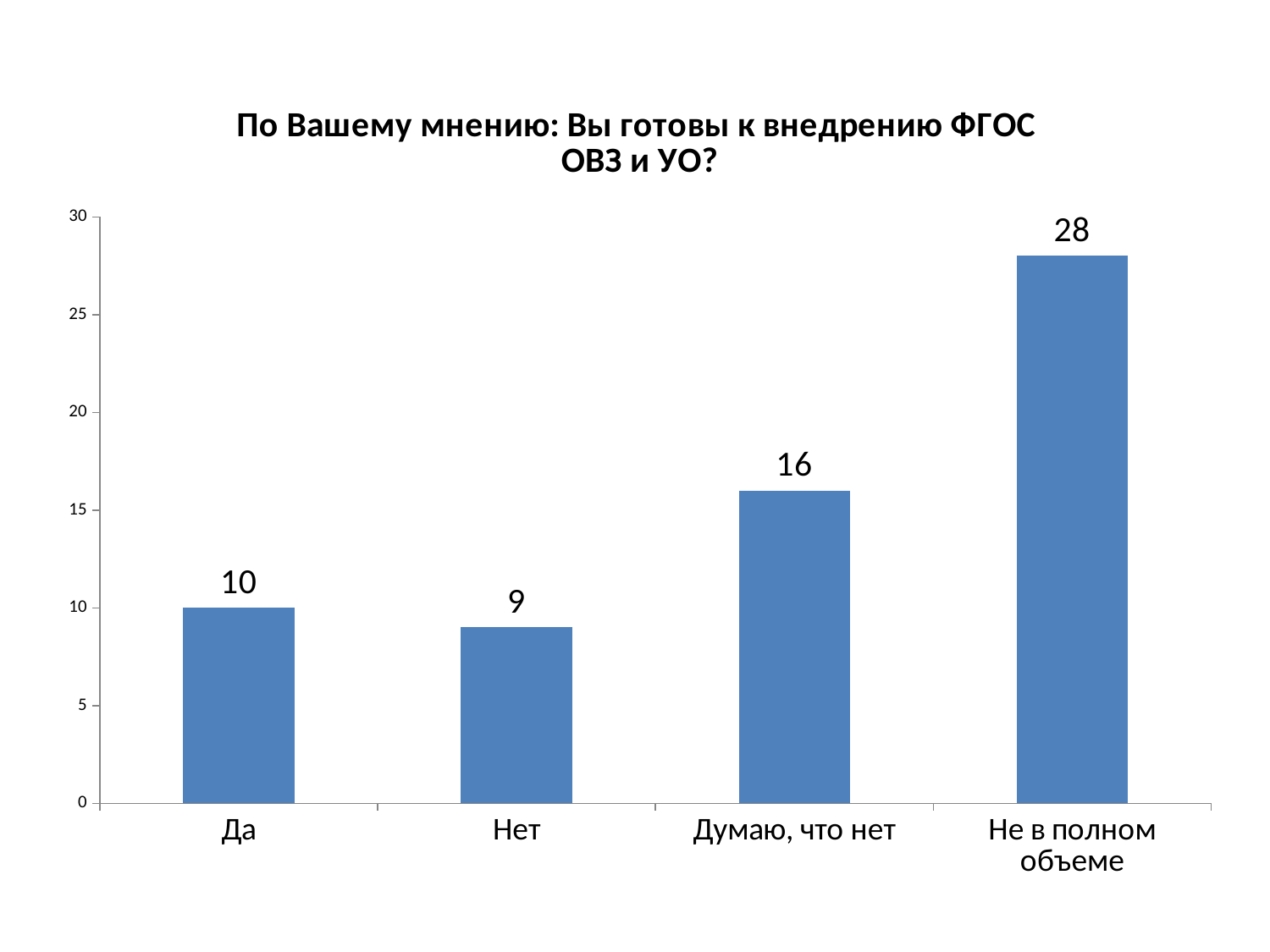
Is the value for "Не в полном объеме" greater or less than 25? greater What is the difference between the values for "Не в полном объеме" and "Думаю, что нет"? 12 Which category has the lowest value? Нет How many categories are shown on the chart? 4 Which is larger, the value for "Да" or the value for "Думаю, что нет"? Думаю, что нет What is the value for "Не в полном объеме"? 28 What is the value for "Да"? 10 What is the value for "Думаю, что нет"? 16 What is the title of the chart? По Вашему мнению: Вы готовы к внедрению ФГОС ОВЗ и УО? Which category has the highest value? Не в полном объеме What is the value for "Нет"? 9 What kind of chart is shown on the slide? bar chart